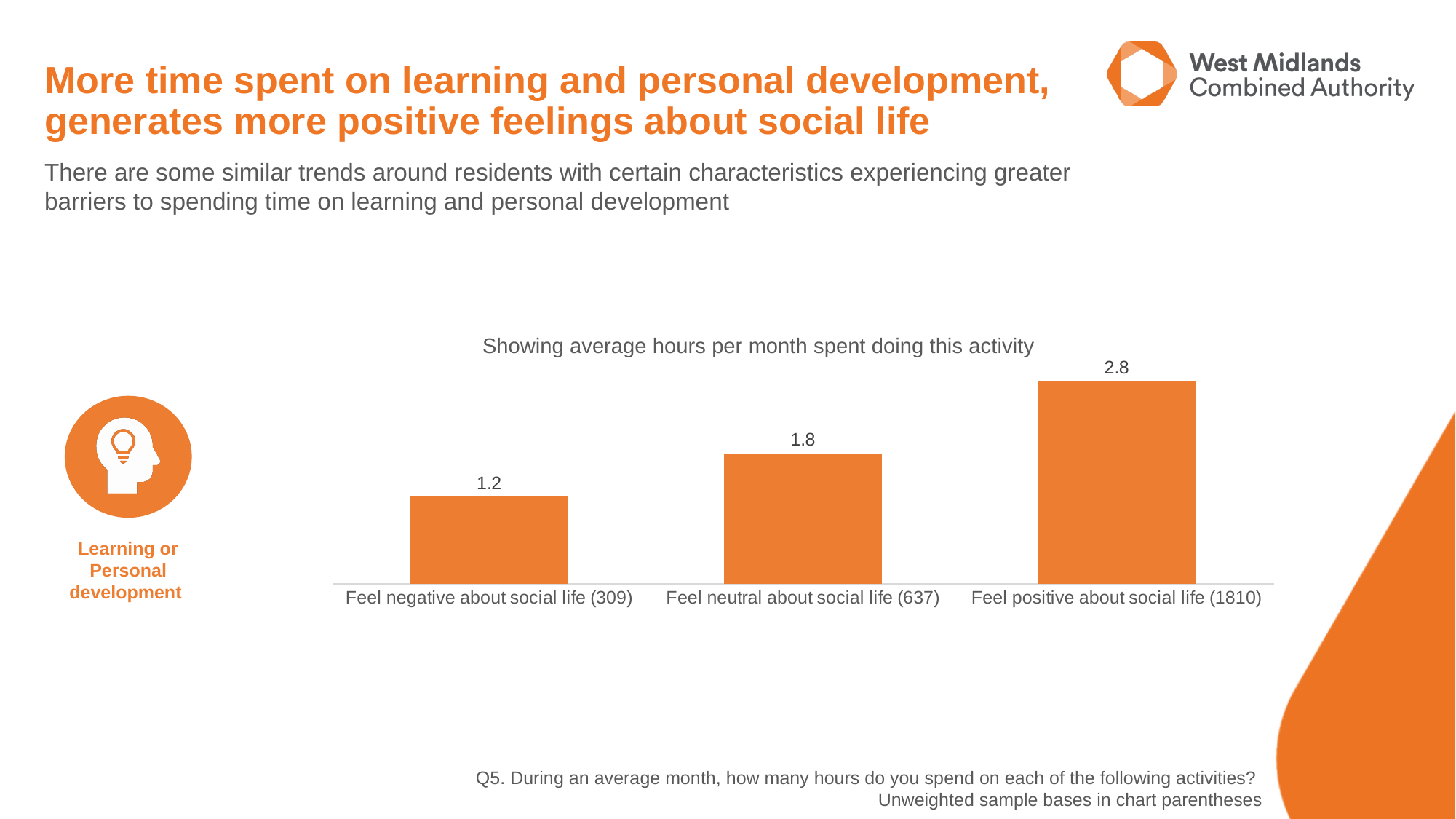
What is the average hours per month spent on learning or personal development for residents who feel neutral about social life? 1.8 What kind of chart is shown on the slide? Bar chart Which category has the lowest average hours per month? Feel negative about social life (309) What is the unweighted sample base for residents who feel neutral about social life? 637 Do the values rise or fall moving from left to right across the categories? Rise What is the average hours per month spent on learning or personal development for residents who feel positive about social life? 2.8 What is the difference in average hours per month between residents who feel neutral and those who feel negative about social life? 0.6 Which category has the highest average hours per month? Feel positive about social life (1810) How many categories are shown in the chart? 3 Which is larger: the value for residents who feel neutral about social life or those who feel positive about social life? Feel positive about social life What is the average hours per month spent on learning or personal development for residents who feel negative about social life? 1.2 What is the difference in average hours per month between residents who feel positive and those who feel negative about social life? 1.6